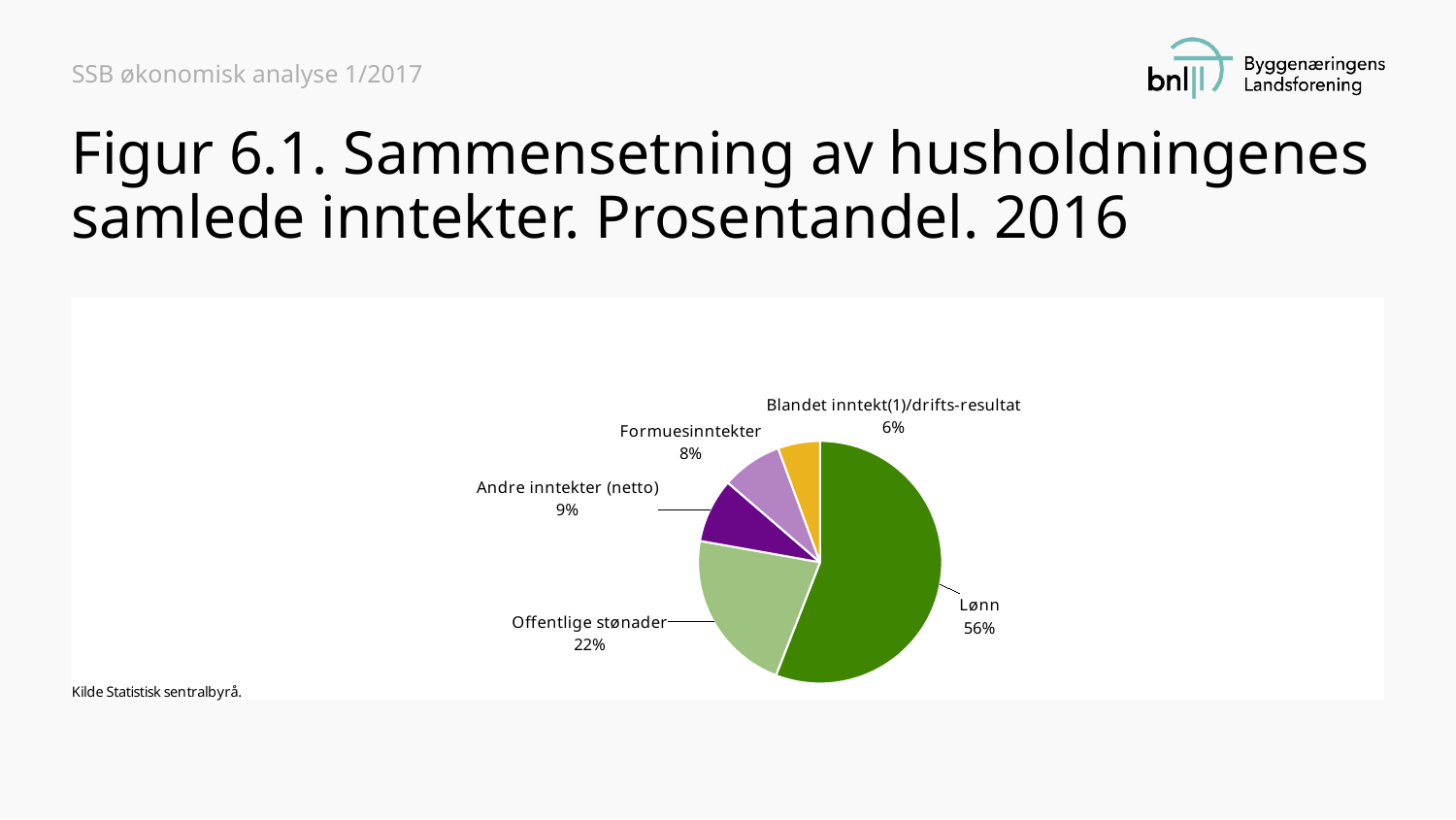
How many slices does the pie chart have? 5 Which category has the smallest share of the pie? Blandet inntekt(1)/drifts-resultat What is the value for Formuesinntekter? 8% What share of households' total income does Lønn account for? 56% What is the value for Offentlige stønader? 22% What is the difference in percentage points between Lønn and Offentlige stønader? 34 What is the source cited below the chart? Kilde Statistisk sentralbyrå. What is the value for Andre inntekter (netto)? 9% What is the value for Blandet inntekt(1)/drifts-resultat? 6% What kind of chart is shown on the slide? pie chart Which is larger, Andre inntekter (netto) or Formuesinntekter? Andre inntekter (netto) Which category has the largest share of the pie? Lønn